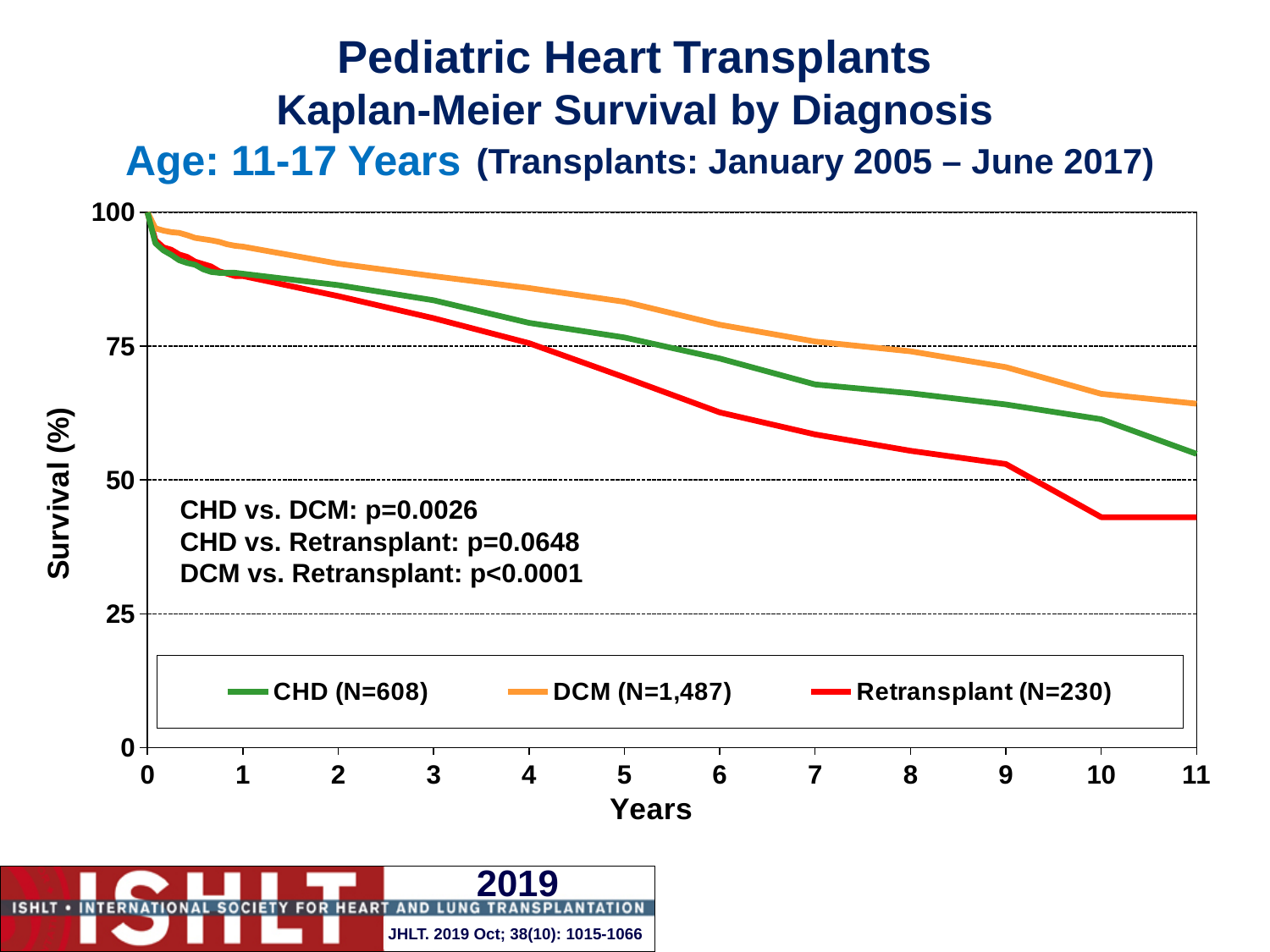
Do the survival curves rise or fall as the years increase along the x axis? Fall How many series does the legend list? 3 What p-value is shown for the comparison of DCM vs. Retransplant? p<0.0001 Is the survival value for DCM at 5 years greater or less than 75? greater Is the survival value for Retransplant at 6 years greater or less than 75? less Which diagnosis group has the lowest survival at 11 years? Retransplant Which diagnosis group has the highest survival at 11 years? DCM At 9 years, which group has higher survival, CHD or Retransplant? CHD Is the survival value for Retransplant at 11 years greater or less than 50? less What kind of chart is shown on the slide? Line chart What is the N shown in the legend for the DCM group? N=1,487